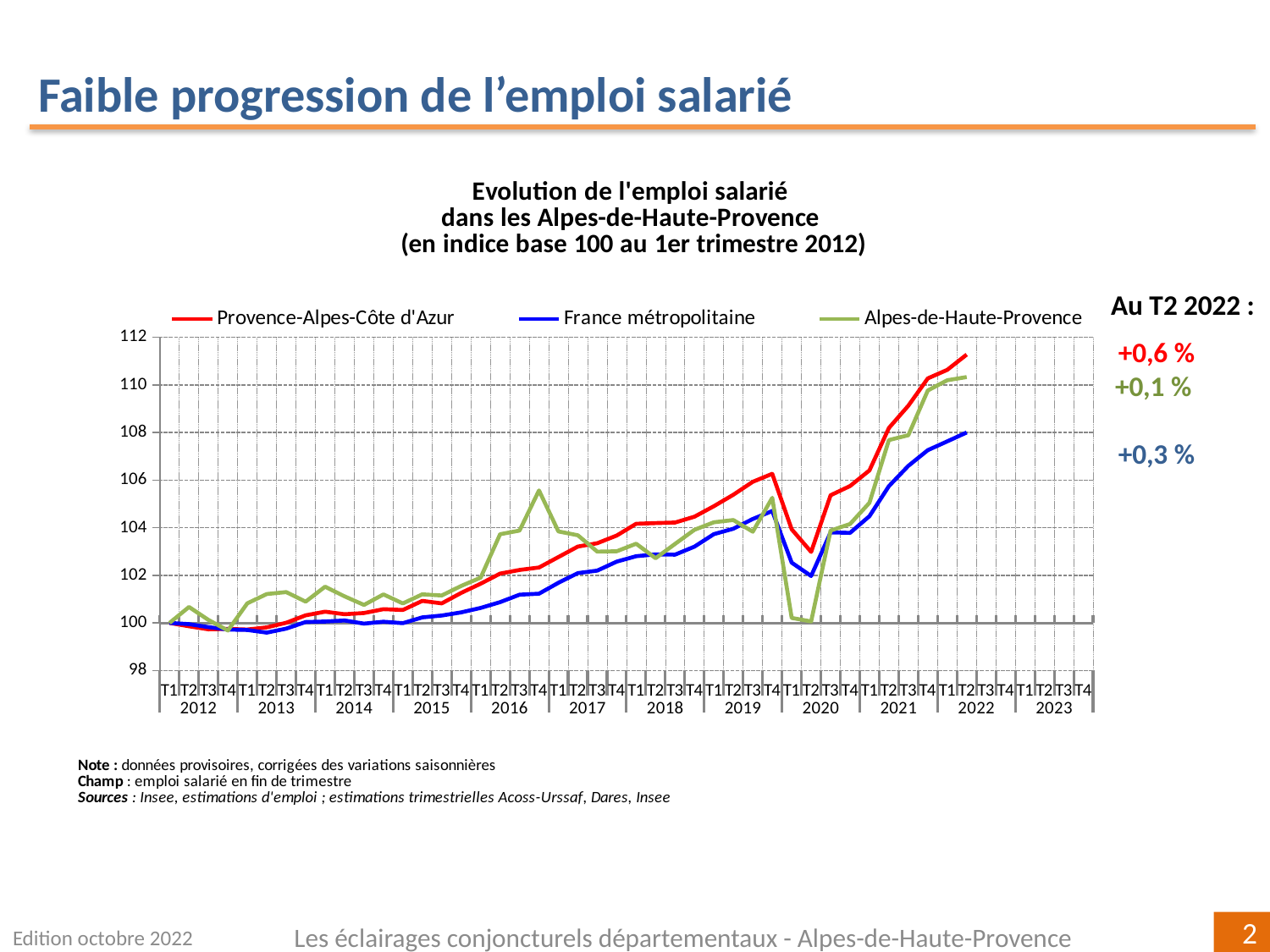
Is the value for Alpes-de-Haute-Provence at T4 2016 greater or less than 104? greater Which series is highest at T2 2022? Provence-Alpes-Côte d'Azur According to the annotation at T2 2022, what is the change for France métropolitaine? +0,3 % According to the annotation at T2 2022, what is the change for Provence-Alpes-Côte d'Azur? +0,6 % Which series is lowest at T2 2022? France métropolitaine Is the value for Provence-Alpes-Côte d'Azur at T2 2022 greater or less than 110? greater Does the France métropolitaine series overall rise or fall from 2012 to 2022? rise Which series is lowest at T2 2020? Alpes-de-Haute-Provence What kind of chart is shown on the slide? line chart Is the value for Alpes-de-Haute-Provence at T2 2020 greater or less than 102? less How many series does the legend list? 3 At T4 2016, which is higher: Alpes-de-Haute-Provence or Provence-Alpes-Côte d'Azur? Alpes-de-Haute-Provence